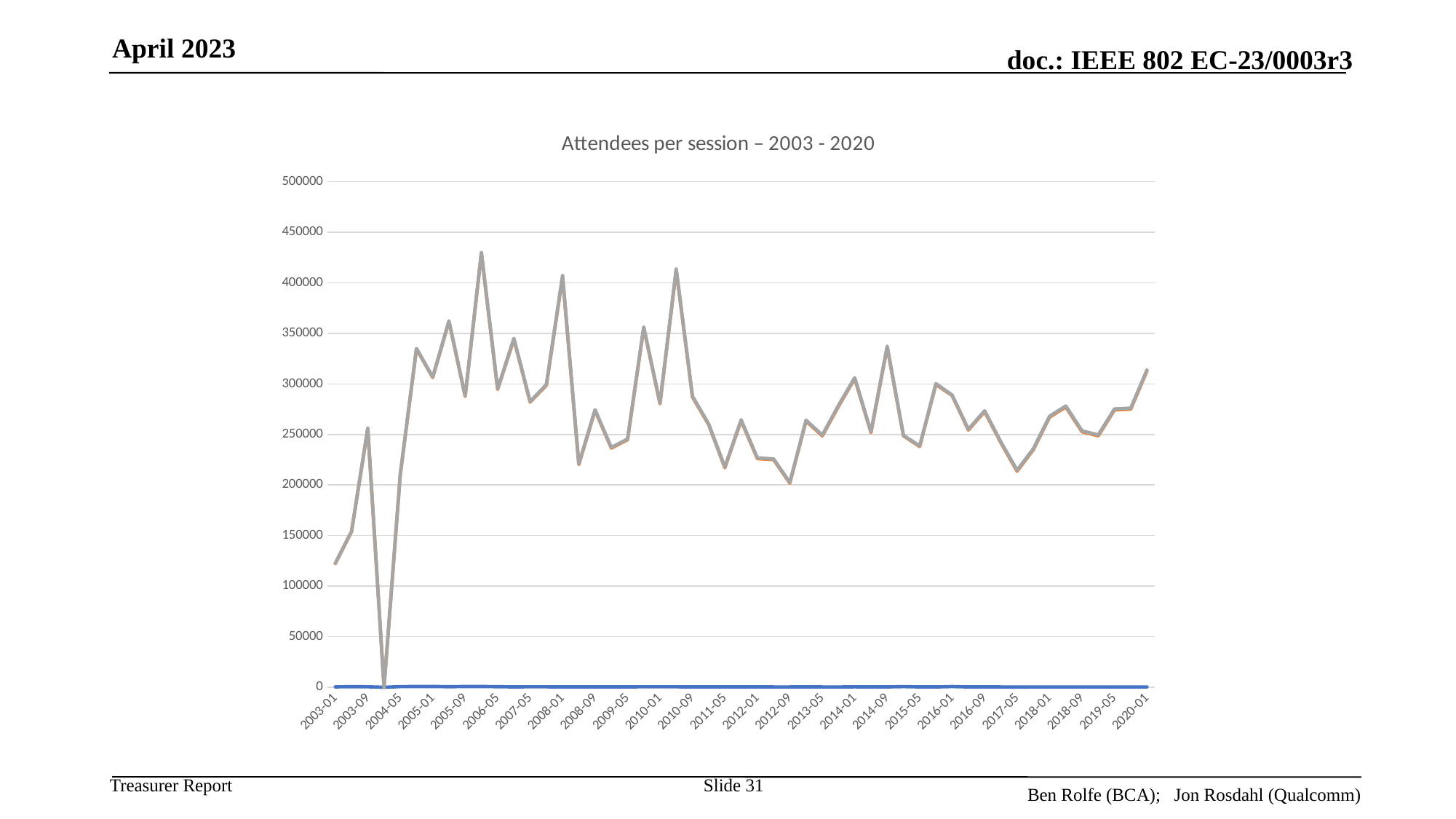
Is the value for 2003-01 greater or less than 150000? less What is the highest value shown on the vertical axis? 500000 Which has the larger value, 2003-01 or 2020-01? 2020-01 What is the title of the chart? Attendees per session – 2003 - 2020 Does the value rise or fall from 2003-01 to 2003-09? rise Which has the larger value, 2014-09 or 2015-05? 2014-09 What kind of chart is shown on the slide? line chart Is the value for 2014-09 greater or less than 300000? greater Is the value for 2004-05 greater or less than 50000? greater